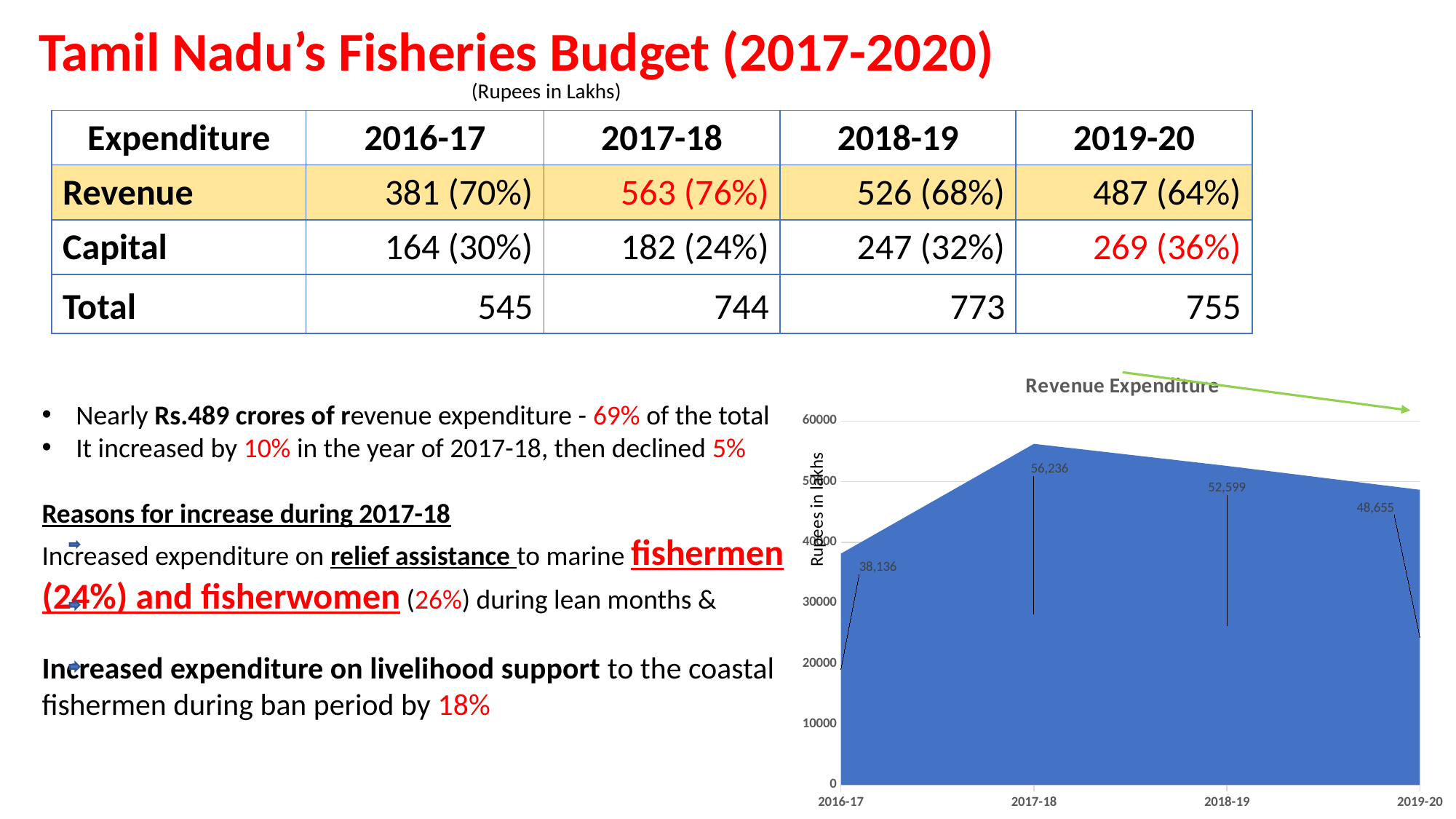
What type of chart is used to show Revenue Expenditure? Area chart What is the revenue expenditure value for 2019-20 in the chart? 48,655 What is the difference between the revenue expenditure in 2017-18 and 2016-17 in the chart? 18,100 What is the label of the y axis of the chart? Rupees in lakhs Is the revenue expenditure for 2018-19 greater or less than 50000? greater What is the revenue expenditure value for 2016-17 in the chart? 38,136 Which year has the highest revenue expenditure in the chart? 2017-18 How many years are plotted on the x axis of the chart? 4 Which year has the lowest revenue expenditure in the chart? 2016-17 What is the revenue expenditure value for 2017-18 in the chart? 56,236 What is the revenue expenditure value for 2018-19 in the chart? 52,599 What is the title of the chart? Revenue Expenditure